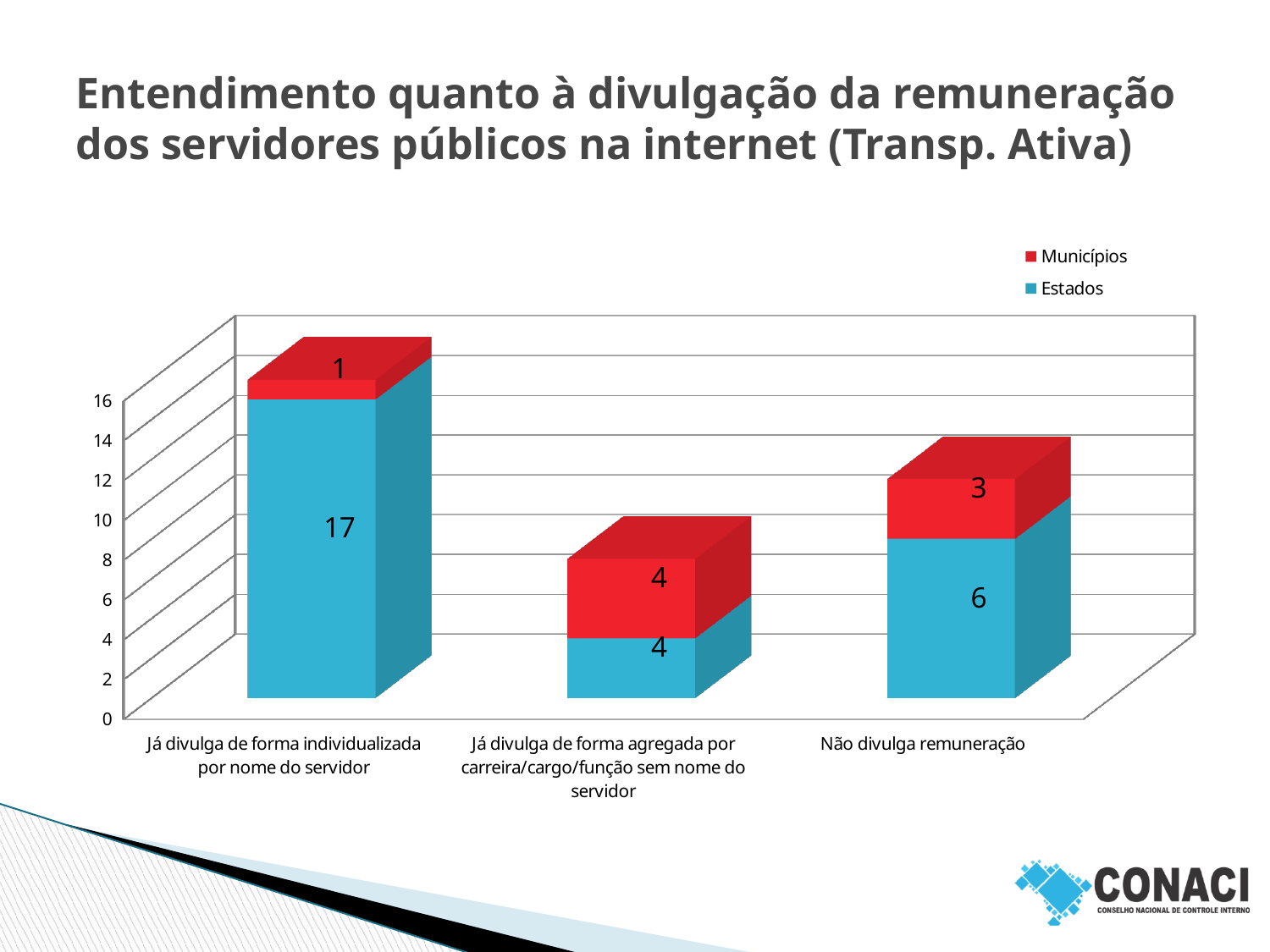
Which is larger: the Municípios value for "Já divulga de forma agregada por carreira/cargo/função sem nome do servidor" or the Municípios value for "Não divulga remuneração"? Já divulga de forma agregada por carreira/cargo/função sem nome do servidor How many series does the legend list? 2 What is the value for Municípios in the category "Não divulga remuneração"? 3 What is the value for Municípios in the category "Já divulga de forma agregada por carreira/cargo/função sem nome do servidor"? 4 What is the total of the stacked bar for "Não divulga remuneração"? 9 Which category has the lowest value for Municípios? Já divulga de forma individualizada por nome do servidor What is the difference between the Estados values for "Já divulga de forma individualizada por nome do servidor" and "Não divulga remuneração"? 11 Which category has the highest value for Estados? Já divulga de forma individualizada por nome do servidor How many categories are shown on the x axis? 3 What is the total of the stacked bar for "Já divulga de forma individualizada por nome do servidor"? 18 What is the value for Estados in the category "Não divulga remuneração"? 6 What is the value for Estados in the category "Já divulga de forma individualizada por nome do servidor"? 17